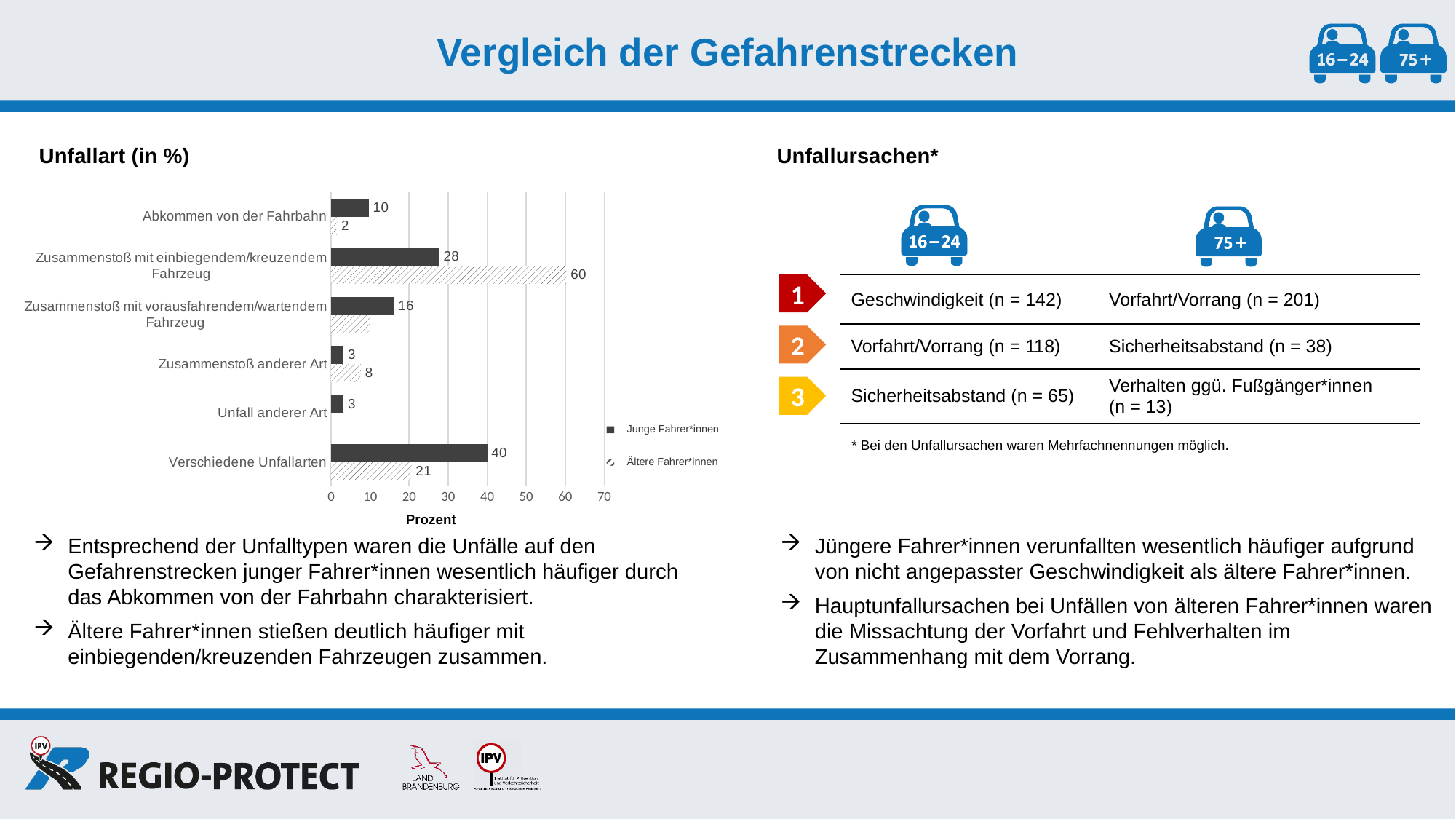
In the "Unfallart (in %)" chart, which category has the highest value for Junge Fahrer*innen? Verschiedene Unfallarten In the "Unfallart (in %)" chart, what is the value for Ältere Fahrer*innen for "Zusammenstoß mit einbiegendem/kreuzendem Fahrzeug"? 60 In the "Unfallart (in %)" chart, is the value for Ältere Fahrer*innen for "Zusammenstoß mit vorausfahrendem/wartendem Fahrzeug" greater or less than 20? less How many categories are shown in the "Unfallart (in %)" chart? 6 In the "Unfallart (in %)" chart, what is the value for Ältere Fahrer*innen for "Zusammenstoß anderer Art"? 8 In the "Unfallart (in %)" chart, what is the difference between Ältere Fahrer*innen and Junge Fahrer*innen for "Zusammenstoß mit einbiegendem/kreuzendem Fahrzeug"? 32 In the "Unfallart (in %)" chart, what is the value for Junge Fahrer*innen for "Verschiedene Unfallarten"? 40 How many series does the legend of the "Unfallart (in %)" chart list? 2 What type of chart is shown under "Unfallart (in %)"? bar chart In the "Unfallart (in %)" chart, which category has the highest value for Ältere Fahrer*innen? Zusammenstoß mit einbiegendem/kreuzendem Fahrzeug In the "Unfallart (in %)" chart, which series has the larger value for "Verschiedene Unfallarten"? Junge Fahrer*innen In the "Unfallart (in %)" chart, what is the value for Junge Fahrer*innen for "Abkommen von der Fahrbahn"? 10